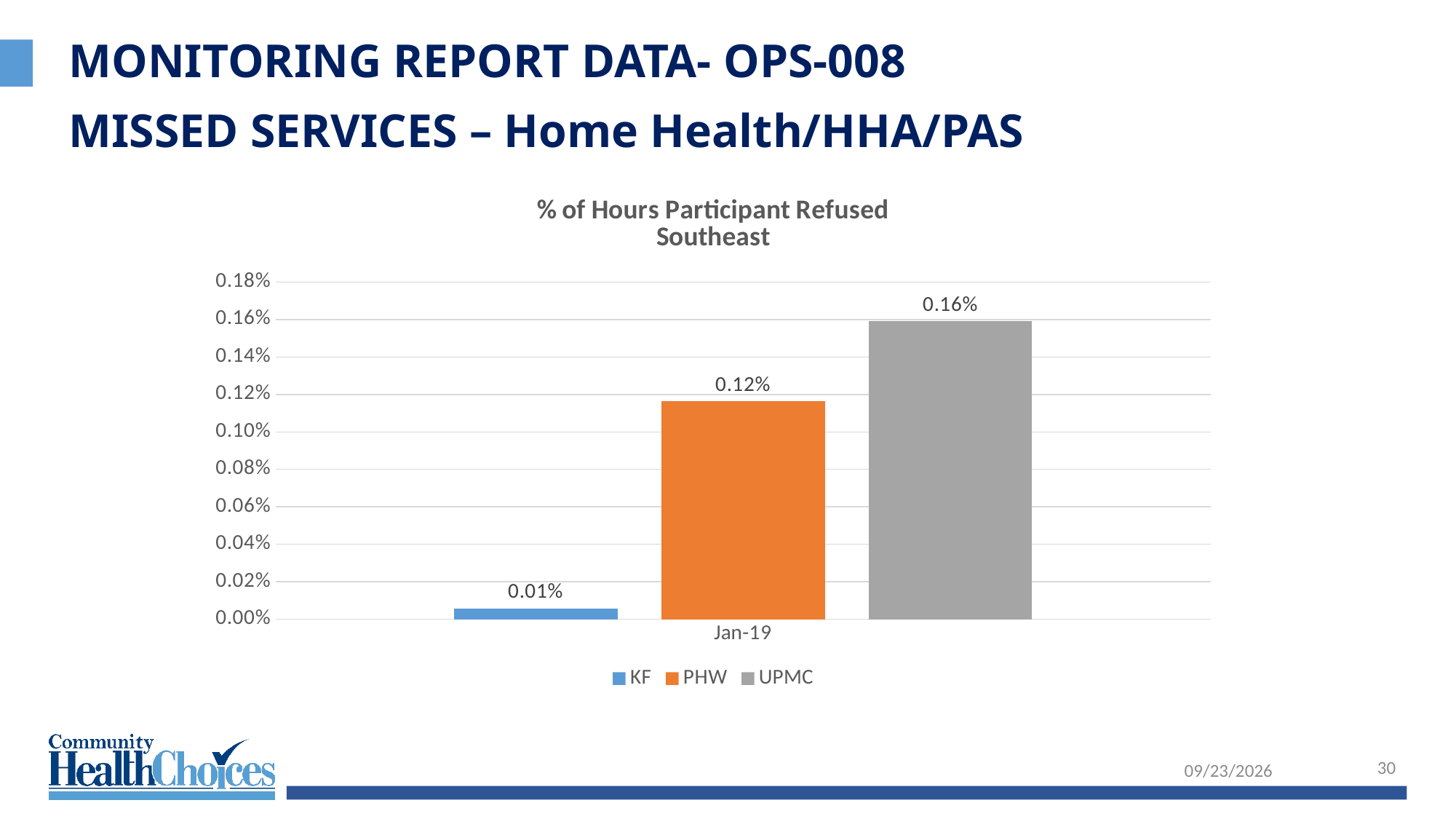
What is the value for PHW in Jan-19? 0.12% What is the difference between the PHW and KF values in Jan-19? 0.11% Which series has the highest value in Jan-19? UPMC What is the value for UPMC in Jan-19? 0.16% What is the difference between the UPMC and PHW values in Jan-19? 0.04% What is the value for KF in Jan-19? 0.01% Which series has the lowest value in Jan-19? KF Is the value for UPMC greater or less than 0.14%? greater Which is larger in Jan-19, the value for PHW or the value for KF? PHW What kind of chart is shown on the slide? Bar chart How many series does the legend list? 3 What is the title of the chart? % of Hours Participant Refused Southeast